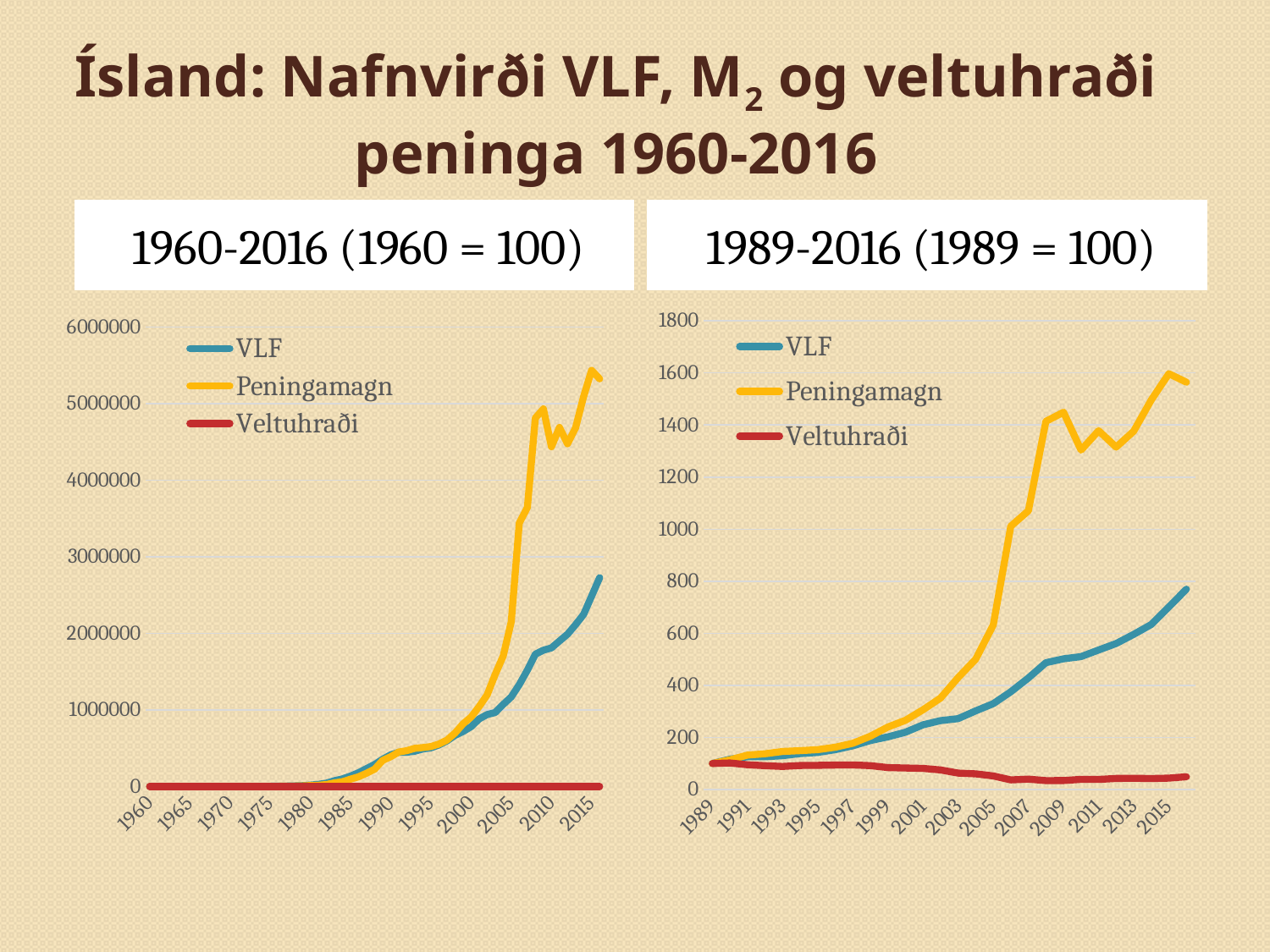
How many series does the legend of the right chart titled "1989-2016 (1989 = 100)" list? 3 In the left chart titled "1960-2016 (1960 = 100)", is the value for VLF in 2016 greater or less than 3000000? less In the left chart titled "1960-2016 (1960 = 100)", what colour is the Peningamagn line? yellow In the left chart titled "1960-2016 (1960 = 100)", which series has the highest value in 2016? Peningamagn In the right chart titled "1989-2016 (1989 = 100)", does the Veltuhraði series rise or fall from 1989 to 2016? fall What kind of chart is the left chart titled "1960-2016 (1960 = 100)"? line chart In the right chart titled "1989-2016 (1989 = 100)", is the value for Peningamagn in 2016 greater or less than 1400? greater In the right chart titled "1989-2016 (1989 = 100)", is the value for Veltuhraði in 2016 greater or less than 200? less In the right chart titled "1989-2016 (1989 = 100)", which is larger in 2016, VLF or Peningamagn? Peningamagn In the right chart titled "1989-2016 (1989 = 100)", which series has the lowest value in 2016? Veltuhraði In the right chart titled "1989-2016 (1989 = 100)", does the VLF series rise or fall from 1989 to 2016? rise